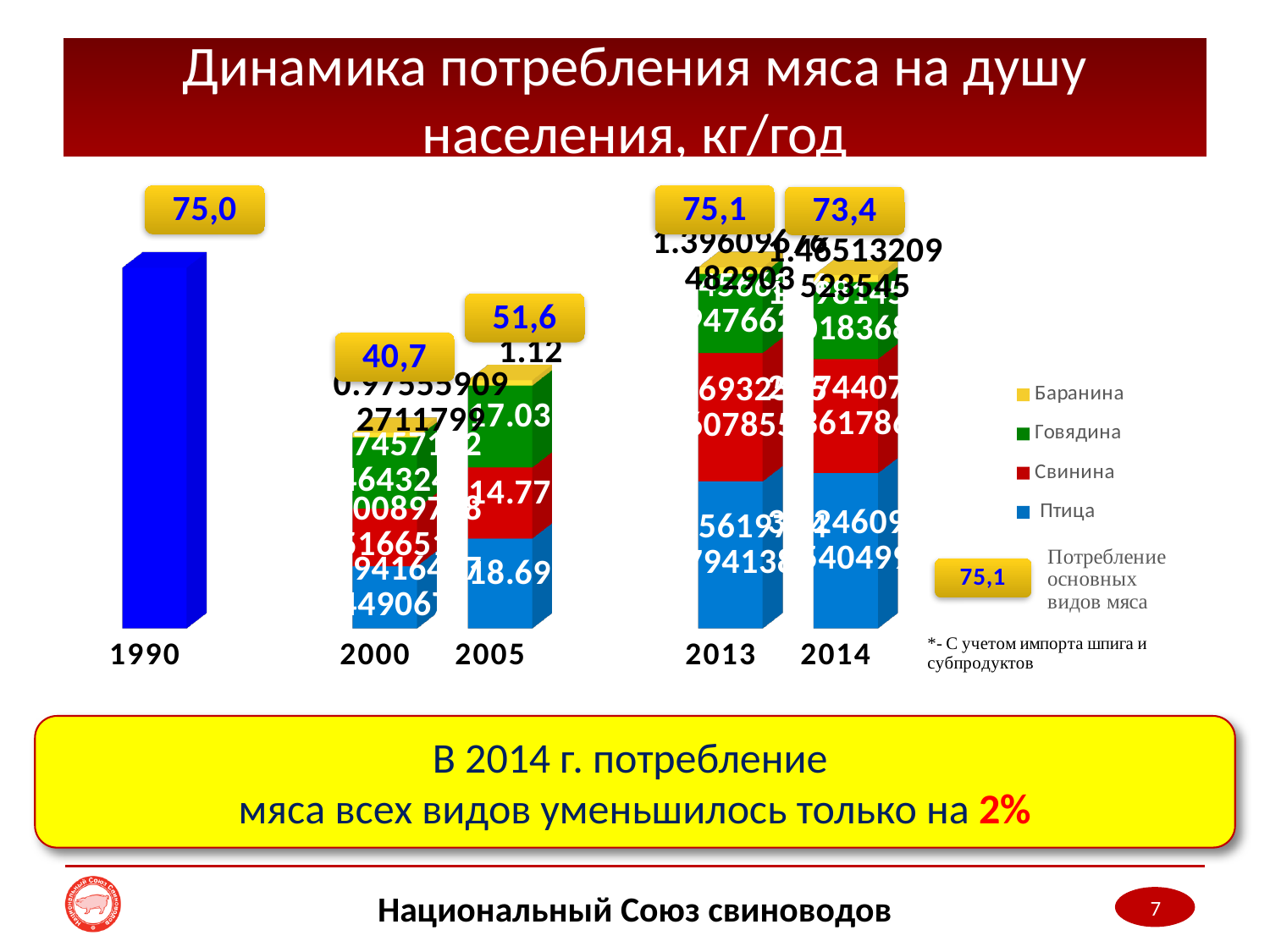
What is the total meat consumption shown for 2014? 73,4 Which colour represents Свинина in the legend? red How many series does the legend list? 4 What is the total meat consumption shown for 2005? 51,6 What is the total meat consumption shown for 1990? 75,0 Which year has the larger total, 2000 or 2005? 2005 Do the totals rise or fall from 2000 to 2013? rise Which year has the lowest total meat consumption? 2000 What is the total meat consumption shown for 2000? 40,7 What is the difference between the totals for 2013 and 2014? 1,7 What kind of chart is shown on the slide? bar chart How many years are shown on the x axis of the chart? 5